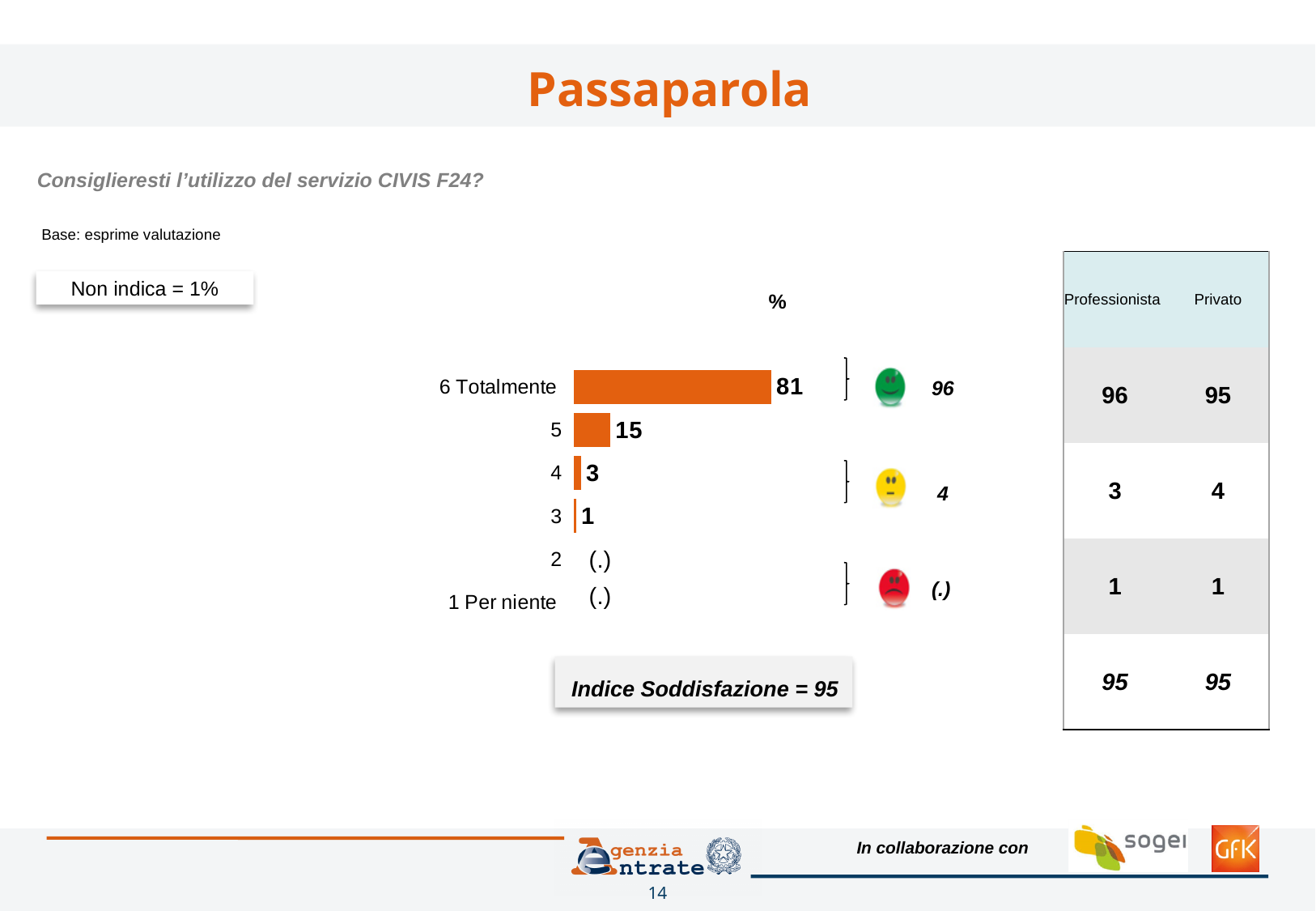
What is the difference between the values for "6 Totalmente" and "5"? 66 How many categories are shown on the chart? 6 What is the value for the category "5"? 15 What unit is indicated above the bars? % What is the value for the category "6 Totalmente"? 81 Which is larger, the value for "5" or the value for "4"? 5 What is the Indice Soddisfazione shown below the chart? 95 What kind of chart is shown on the slide? bar chart Which category has the highest value? 6 Totalmente What is the value for the category "3"? 1 What is the combined value of the categories "6 Totalmente" and "5", as shown next to the green face? 96 What is the value for the category "4"? 3